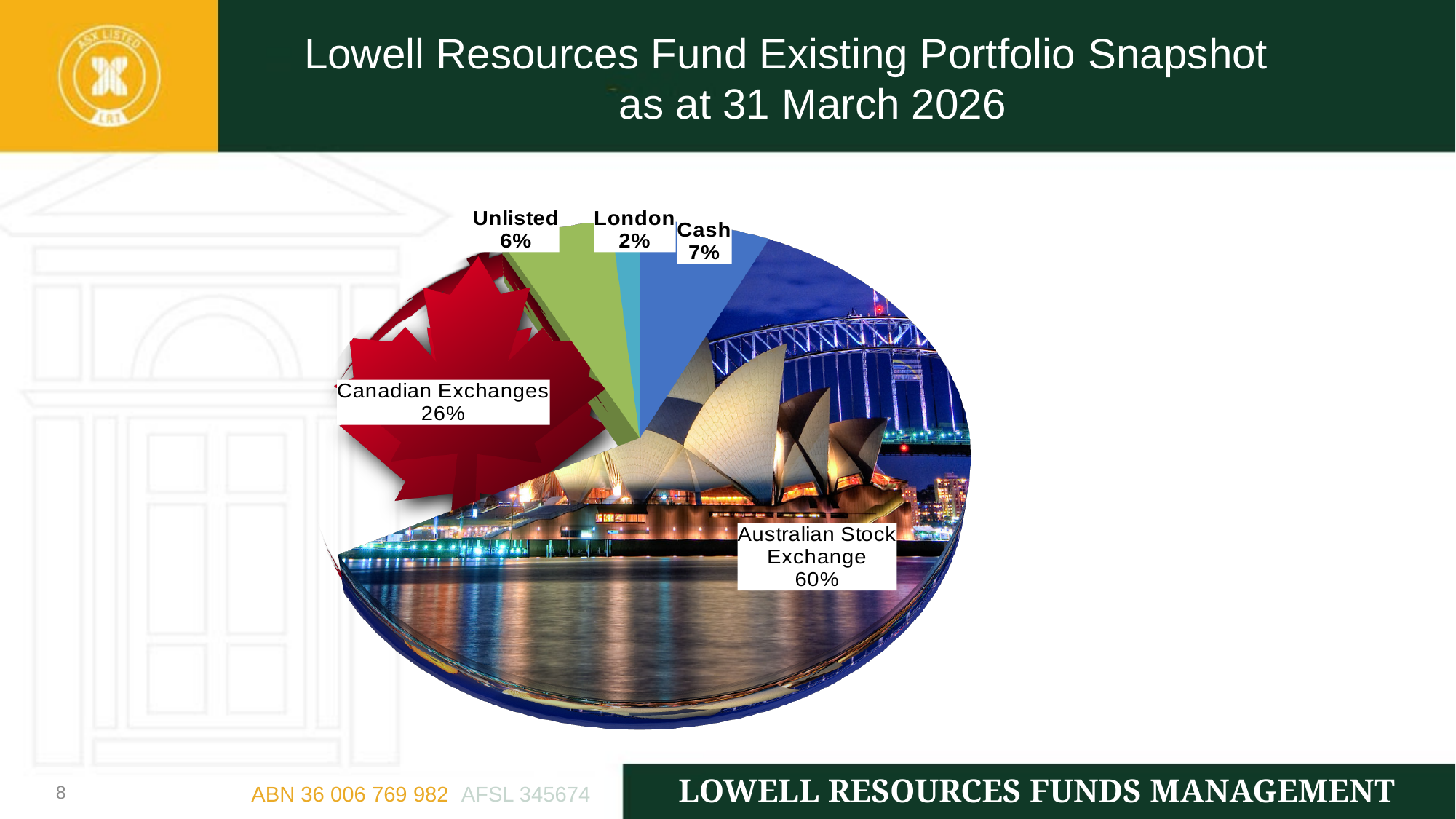
Which is larger, the Cash share or the Unlisted share? Cash How many categories are shown in the pie chart? 5 What share of the portfolio is held on the Australian Stock Exchange? 60% What is the difference in percentage points between the Australian Stock Exchange and Canadian Exchanges shares? 34 percentage points Which category has the largest share of the portfolio? Australian Stock Exchange Which category has the smallest share of the portfolio? London What kind of chart is shown on the slide? Pie chart What percentage of the portfolio is held in London? 2% What percentage of the portfolio is Unlisted? 6% What is the title of the chart slide? Lowell Resources Fund Existing Portfolio Snapshot as at 31 March 2026 What share of the portfolio is held on Canadian Exchanges? 26% What percentage of the portfolio is Cash? 7%